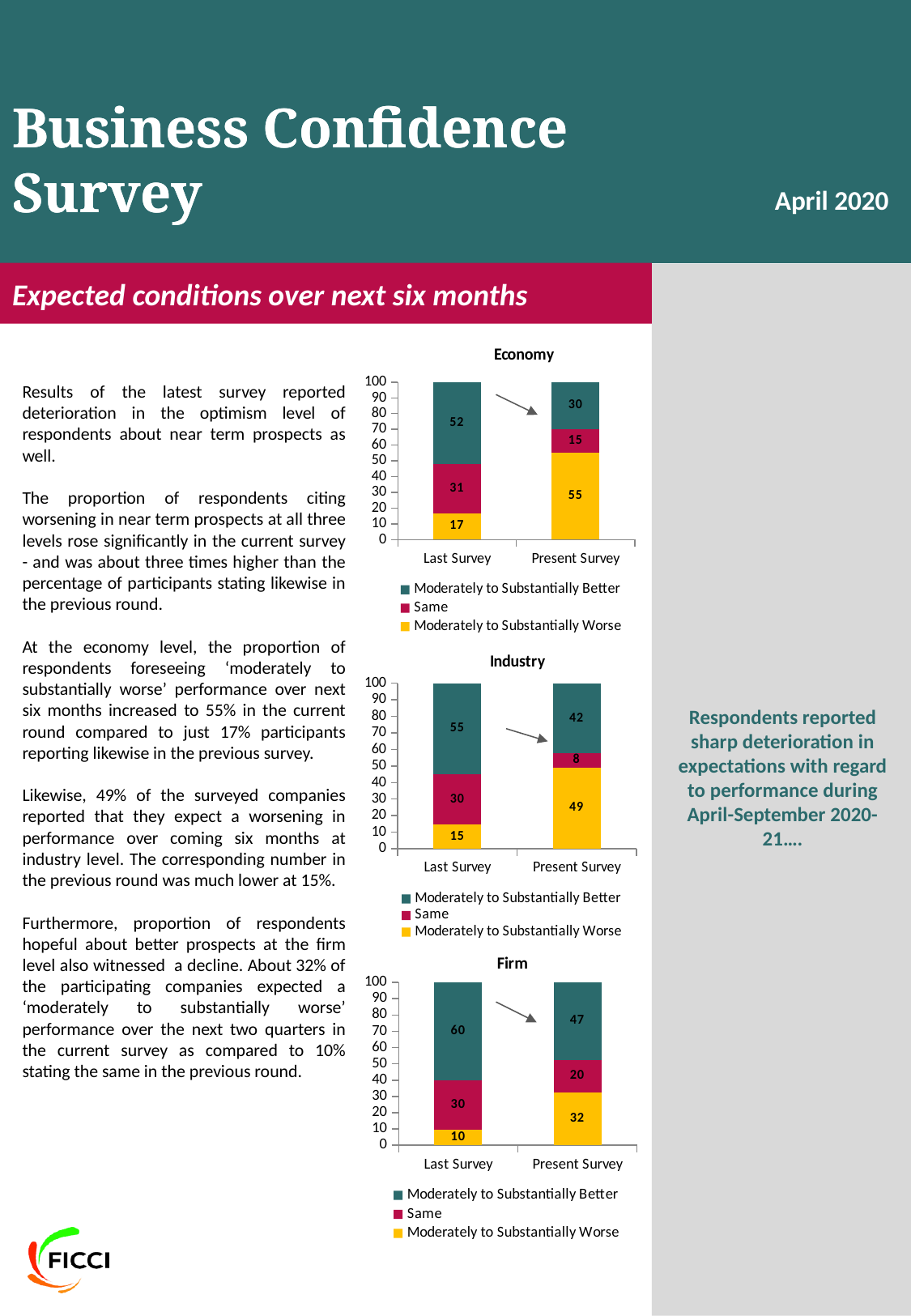
What kind of chart is the Industry chart? Stacked bar chart In the Industry chart, what is the difference between the Moderately to Substantially Worse values for the Present Survey and the Last Survey? 34 In the Industry chart, which segment of the Present Survey bar is the smallest? Same In the Economy chart, what is the value for Moderately to Substantially Worse in the Present Survey? 55 In the Industry chart, what is the value for Moderately to Substantially Better in the Present Survey? 42 In the Economy chart, which is larger in the Present Survey: Moderately to Substantially Better or Moderately to Substantially Worse? Moderately to Substantially Worse In the Economy chart, what is the value for Same in the Last Survey? 31 In the Firm chart, what is the value for Moderately to Substantially Worse in the Last Survey? 10 How many series does the legend of the Economy chart list? 3 In the Firm chart, what is the difference between the Moderately to Substantially Better values for the Last Survey and the Present Survey? 13 In the Economy chart, what is the total of the Last Survey stacked bar? 100 In the Firm chart, which segment of the Last Survey bar is the largest? Moderately to Substantially Better